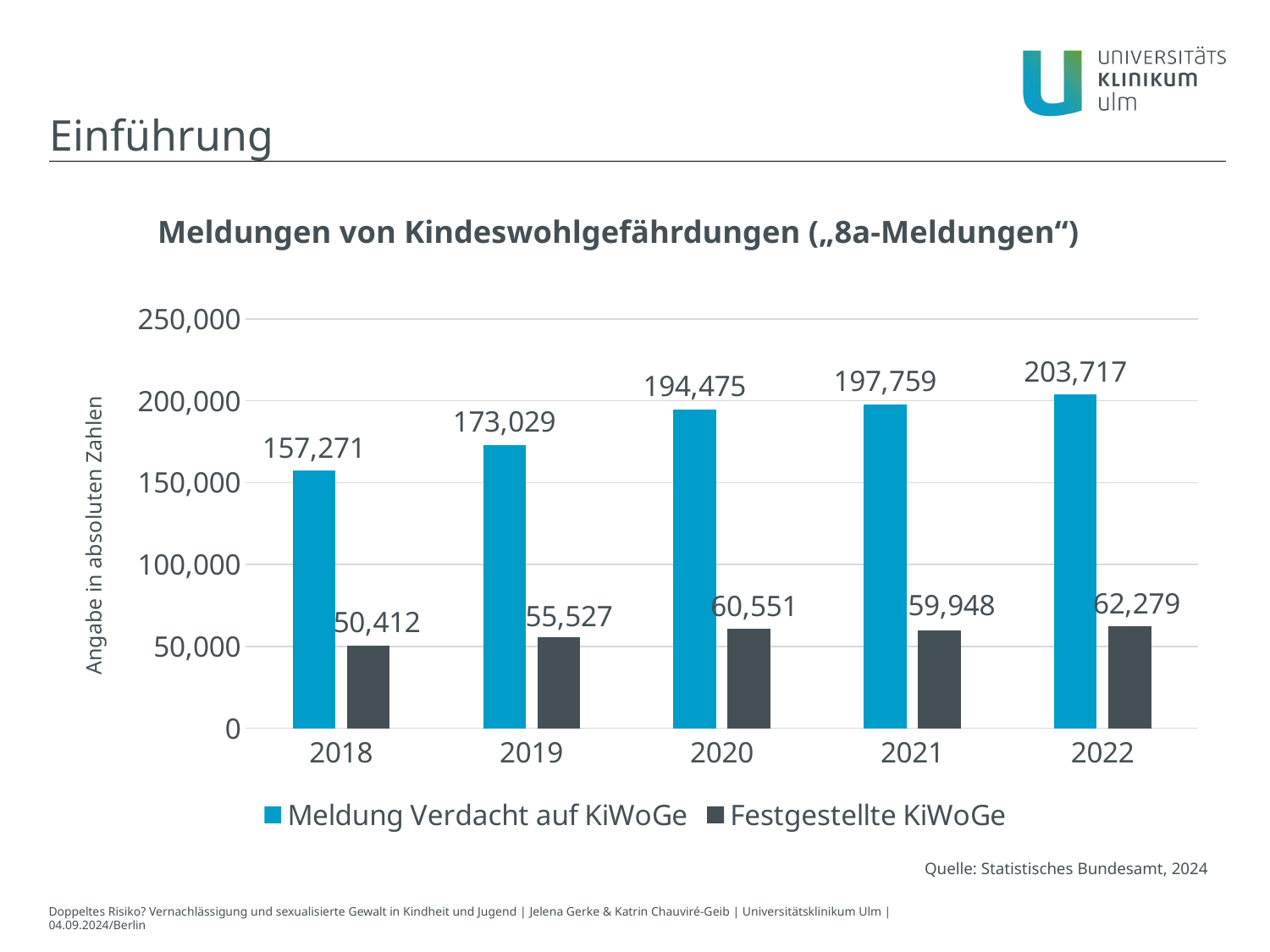
What is the difference between "Meldung Verdacht auf KiWoGe" in 2022 and in 2018? 46,446 What is the value for "Festgestellte KiWoGe" in 2020? 60,551 Which year has the lowest value for "Festgestellte KiWoGe"? 2018 Which is larger: "Festgestellte KiWoGe" in 2020 or in 2021? 2020 Do the values for "Meldung Verdacht auf KiWoGe" rise or fall from 2018 to 2022? rise Is the value for "Meldung Verdacht auf KiWoGe" in 2019 greater or less than 200,000? less What is the value for "Meldung Verdacht auf KiWoGe" in 2018? 157,271 Which year has the highest value for "Meldung Verdacht auf KiWoGe"? 2022 What is the value for "Festgestellte KiWoGe" in 2022? 62,279 What kind of chart is shown on the slide? bar chart How many series does the legend list? 2 How many years are shown on the x axis? 5